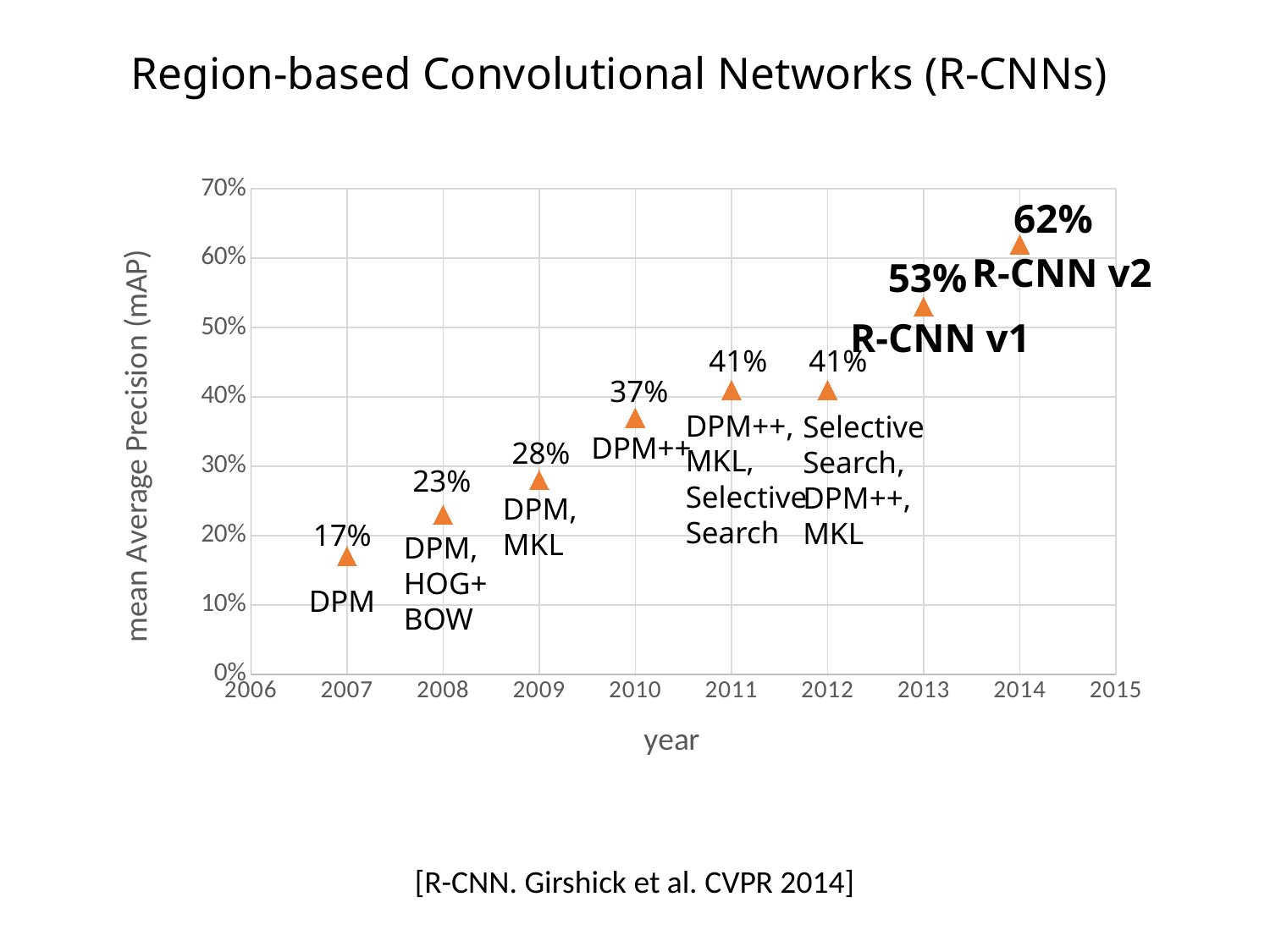
What is the difference in mAP between 2009 and 2008? 5% Which has a higher mAP, 2012 or 2013? 2013 What is the mean Average Precision (mAP) value plotted for 2007? 17% What is the mAP value plotted for 2010? 37% How many data points are plotted on the chart? 8 Which year has the highest mAP value? 2014 What is the mAP value plotted for 2013 (R-CNN v1)? 53% What is the label of the y axis? mean Average Precision (mAP) Do the mAP values generally rise or fall as the year increases? rise Which year has the lowest mAP value? 2007 What is the difference in mAP between 2014 and 2013? 9% What is the mAP value plotted for 2014 (R-CNN v2)? 62%